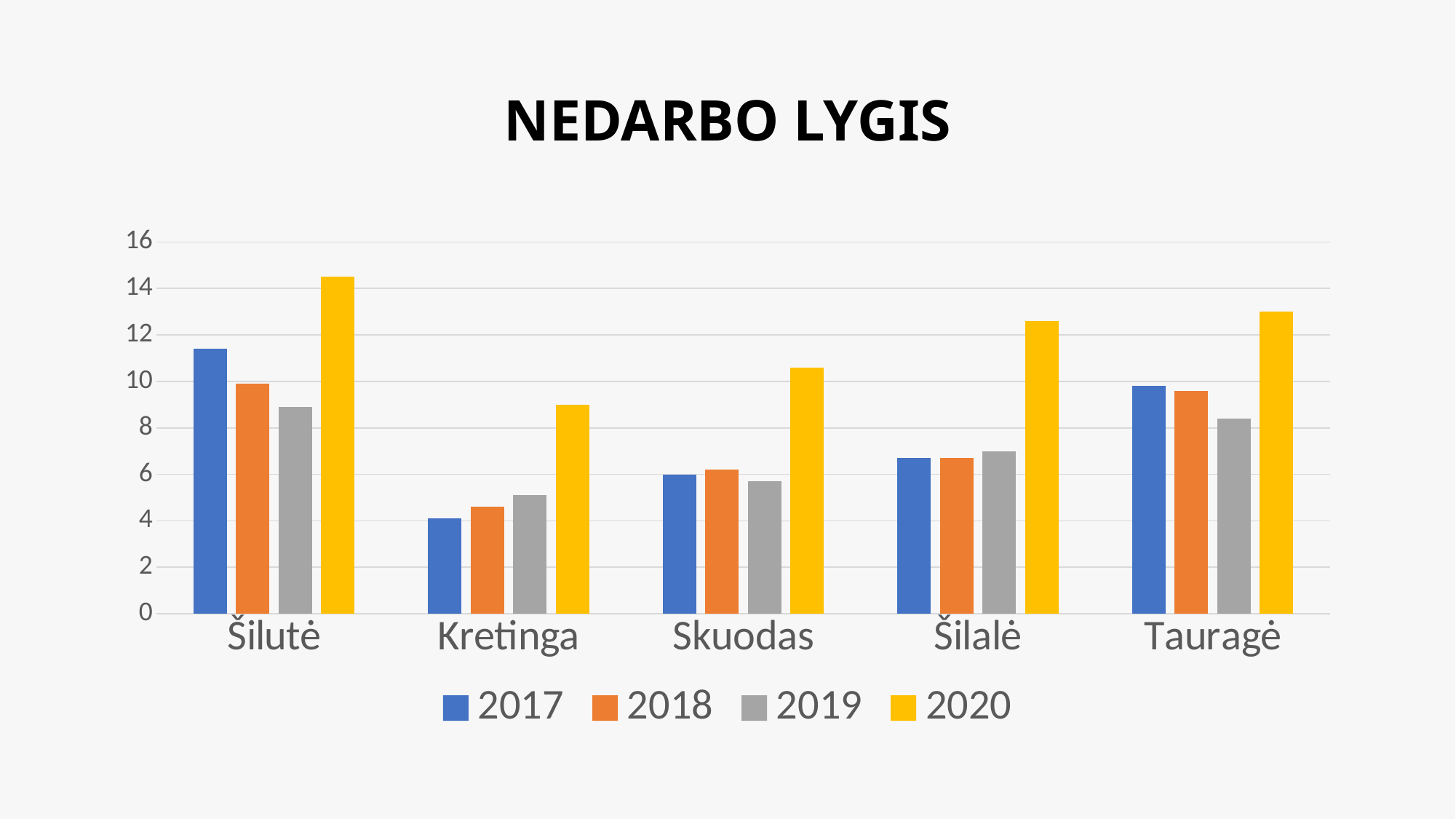
How many categories are shown on the x axis? 5 Which is larger: the 2017 value for Šilutė or the 2017 value for Šilalė? Šilutė Which category has the highest value for 2020? Šilutė Is the value for Kretinga in 2017 greater or less than 6? less Which series is shown in yellow in the legend? 2020 Which category has the lowest value for 2017? Kretinga Is the value for Skuodas in 2020 greater or less than 10? greater What kind of chart is shown on the slide? bar chart Is the value for Šilutė in 2020 greater or less than 14? greater How many series does the legend list? 4 Which is larger for Tauragė: the value for 2019 or the value for 2020? 2020 What is the title of the chart? NEDARBO LYGIS